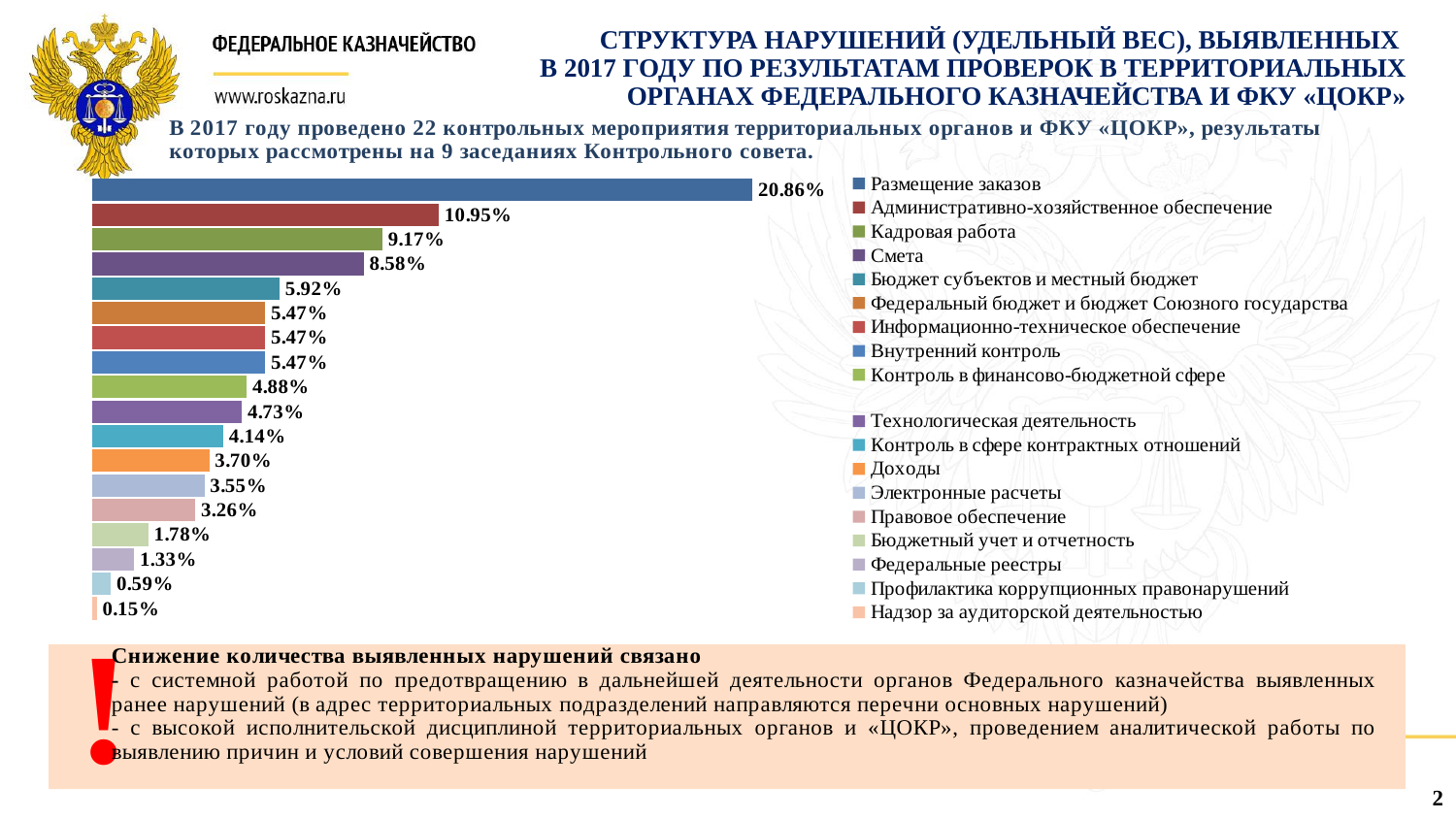
What is the value for Кадровая работа? 9.17% What is the value shown on the shortest bar in the chart? 0.15% What is the value for Смета? 8.58% How many bars are plotted in the chart? 18 What kind of chart is shown on the slide? bar chart Which legend entry is listed last in the legend? Надзор за аудиторской деятельностью How many entries does the legend list? 18 What is the value for Размещение заказов? 20.86% Which legend entry is listed first in the legend? Размещение заказов What is the value shown on the longest bar in the chart? 20.86% What is the difference between the values of the two longest bars (20.86% and 10.95%)? 9.91% Which is larger, the value for Административно-хозяйственное обеспечение or the value for Кадровая работа? Административно-хозяйственное обеспечение